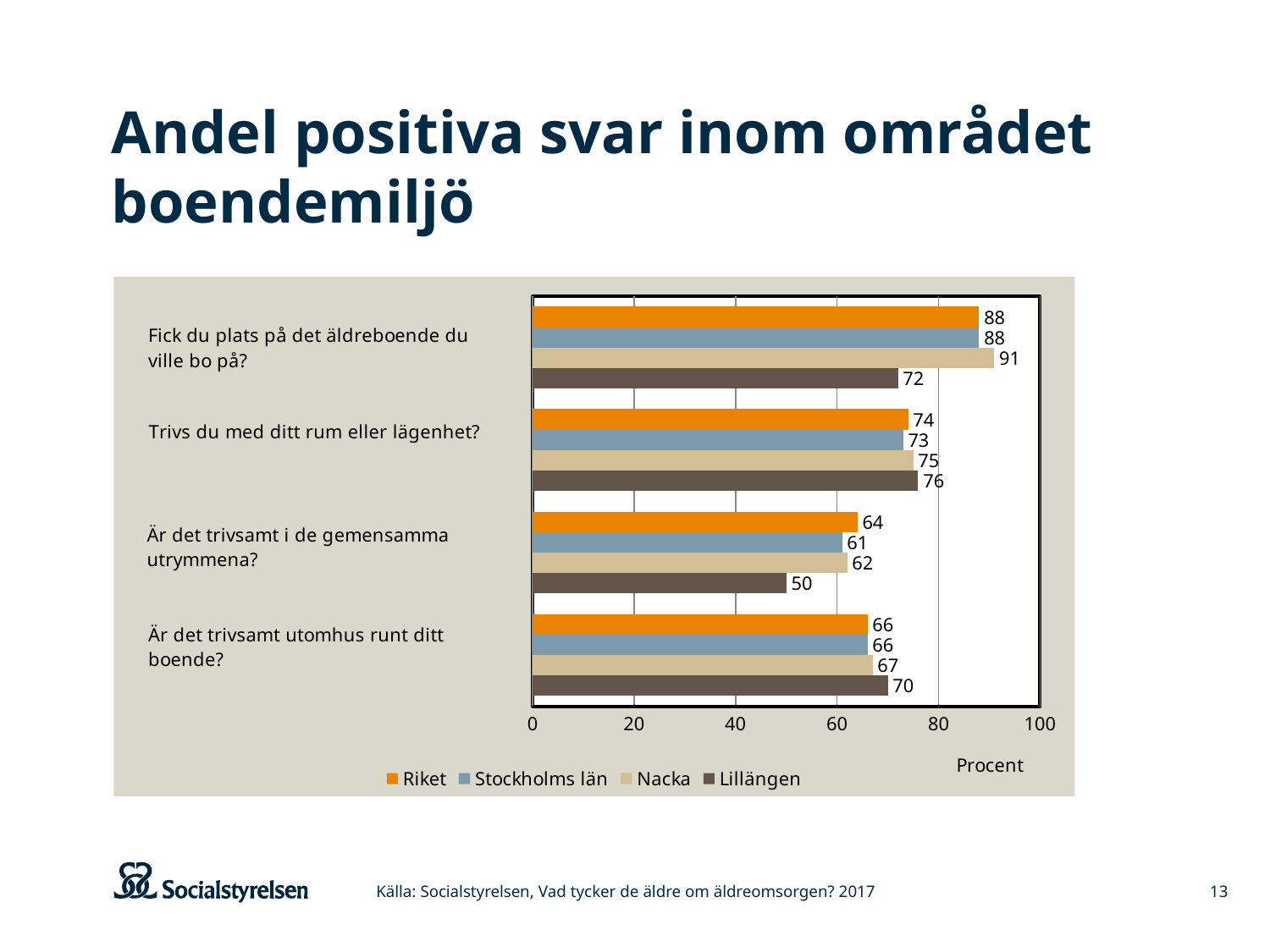
What is the value for Nacka on "Fick du plats på det äldreboende du ville bo på?" 91 What is the value for Stockholms län on "Trivs du med ditt rum eller lägenhet?" 73 Which series has the lowest value on "Är det trivsamt i de gemensamma utrymmena?" Lillängen What is the label on the horizontal axis of the chart? Procent Which is larger on "Är det trivsamt utomhus runt ditt boende?": Lillängen or Riket? Lillängen What kind of chart is shown on the slide? Bar chart What is the difference between Nacka and Lillängen on "Fick du plats på det äldreboende du ville bo på?" 19 What is the value for Lillängen on "Är det trivsamt i de gemensamma utrymmena?" 50 What is the value for Riket on "Är det trivsamt utomhus runt ditt boende?" 66 How many question categories are shown on the chart? 4 How many series does the legend list? 4 Which series has the highest value on "Fick du plats på det äldreboende du ville bo på?" Nacka